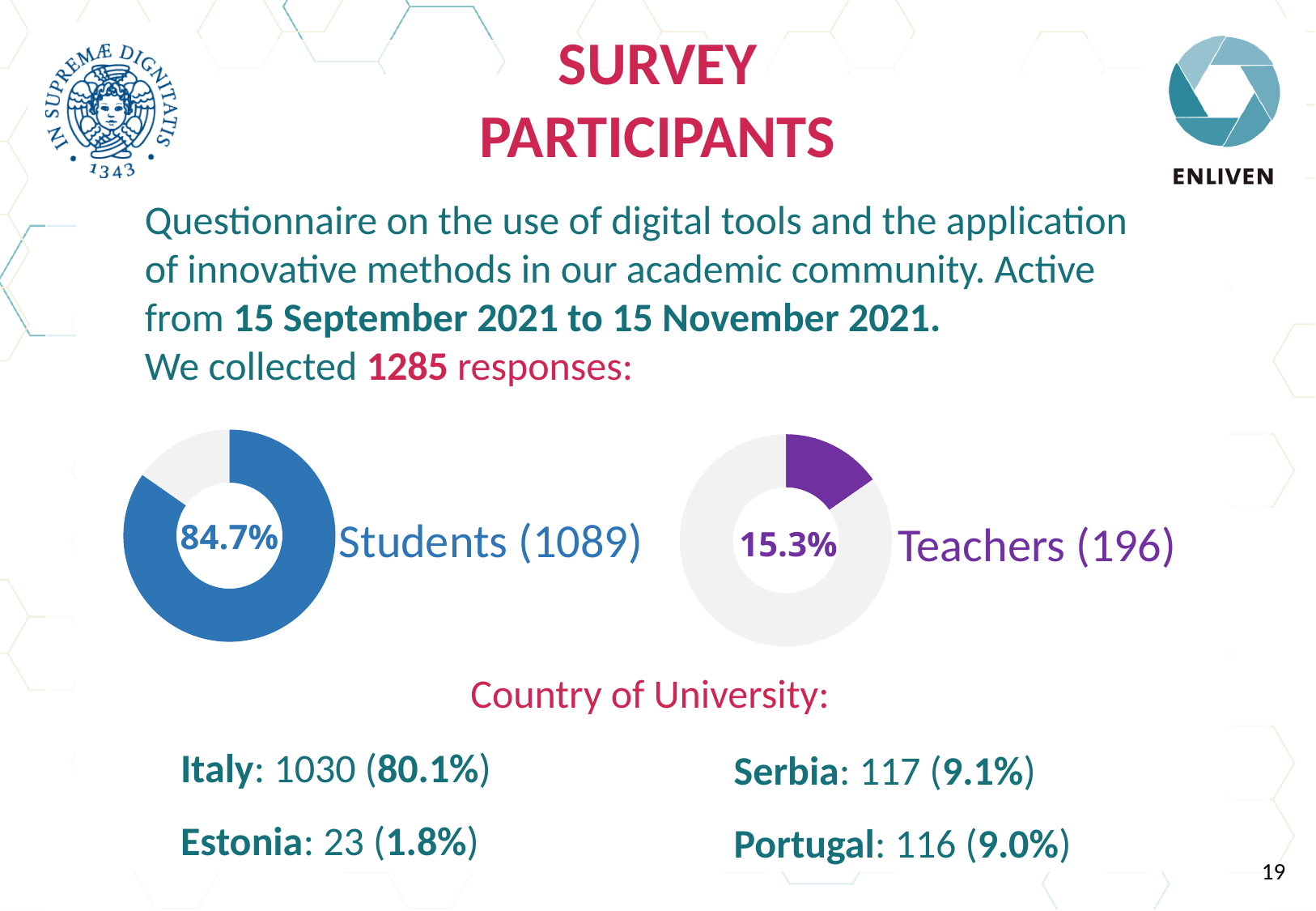
What colour is the filled segment of the Teachers doughnut chart? Purple What colour is the filled segment of the Students doughnut chart? Blue What kind of chart is used to show the share of students and teachers? Doughnut (pie) chart What is the difference in percentage points between the students' share and the teachers' share shown in the two doughnut charts? 69.4 percentage points In the left doughnut chart, what percentage of survey participants are students? 84.7% Is the students' share in the left doughnut chart greater or less than 50%? greater In the right doughnut chart, what percentage of survey participants are teachers? 15.3% How many more students than teachers responded, based on the counts shown next to the two doughnut charts? 893 According to the right doughnut chart, how many teachers responded to the survey? 196 Which group has the larger share of survey participants, students or teachers? Students What is the combined number of students and teachers shown next to the two doughnut charts? 1285 According to the left doughnut chart, how many students responded to the survey? 1089